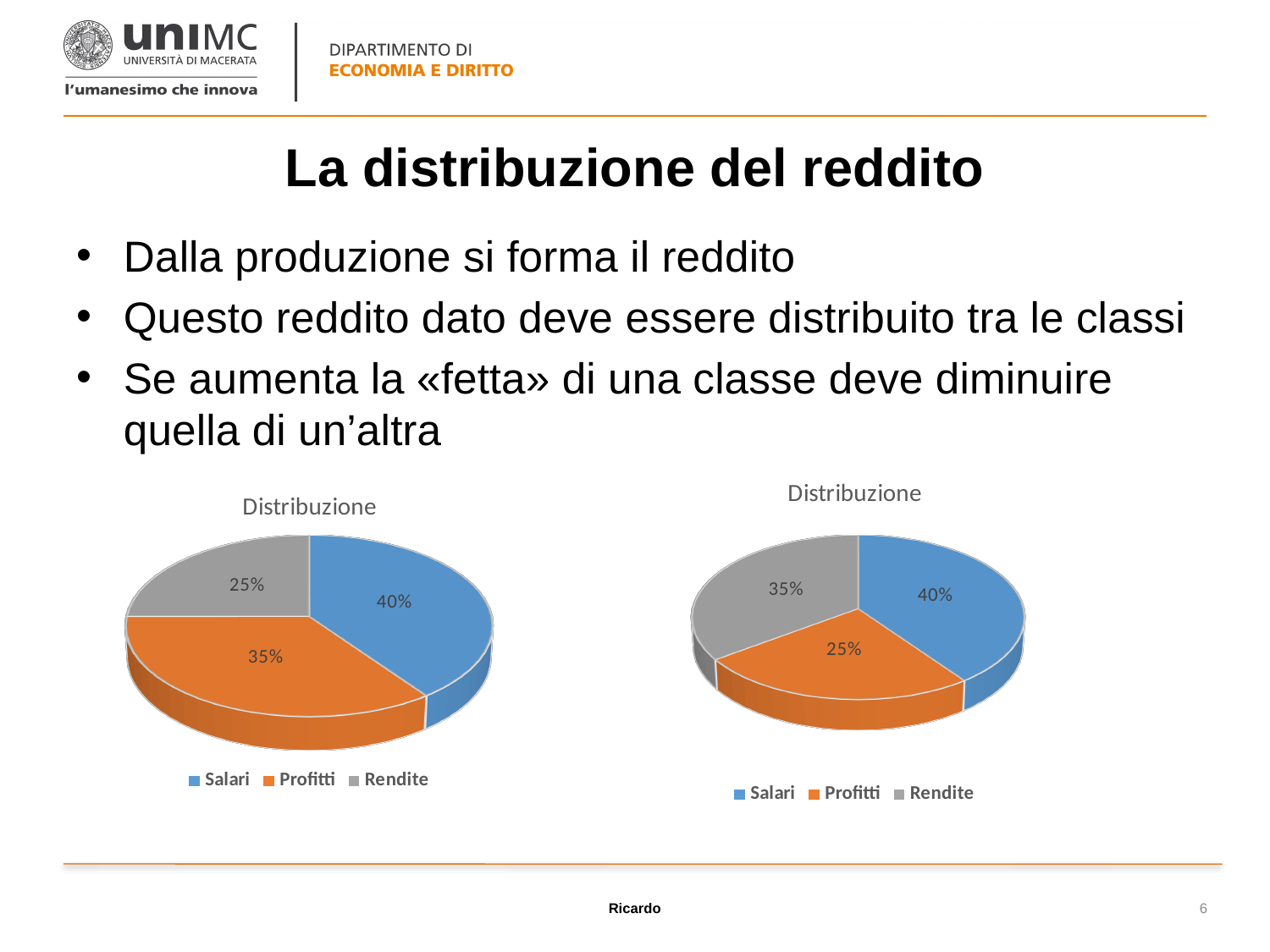
In the right pie chart, what share does Profitti have? 25% In the left pie chart, what share does Profitti have? 35% In the right pie chart, which is larger, Profitti or Rendite? Rendite In the right pie chart, which category has the smallest slice? Profitti What type of chart is shown on the right side of the slide? Pie chart In the left pie chart, what share does Rendite have? 25% In the right pie chart, what share does Rendite have? 35% In the right pie chart, which category has the largest slice? Salari In the left pie chart, which category has the smallest slice? Rendite In the left pie chart, what share does Salari have? 40% How many categories does the legend of the left pie chart list? 3 In the left pie chart, what is the difference between the Salari share and the Rendite share? 15%